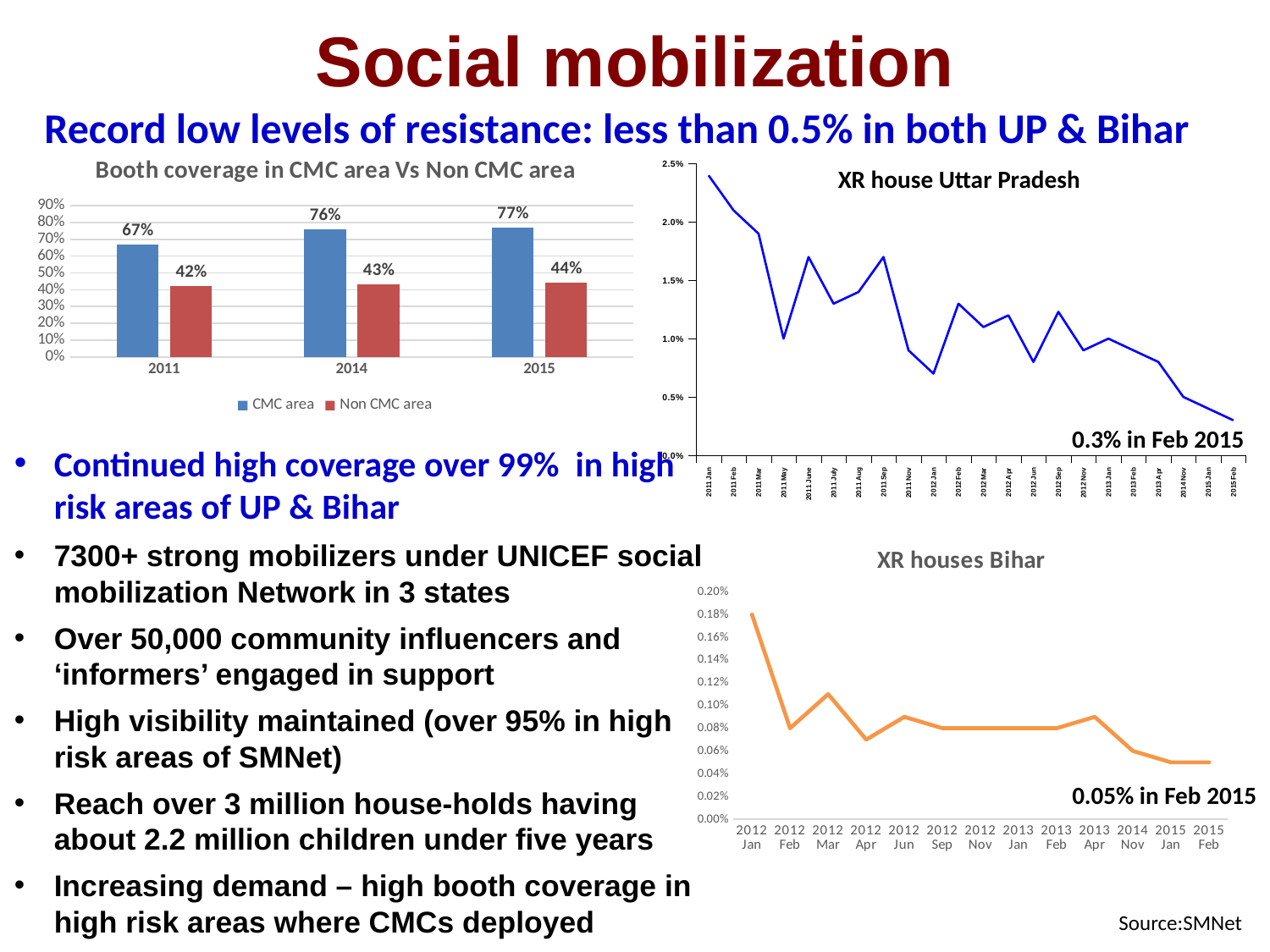
What kind of chart is 'Booth coverage in CMC area Vs Non CMC area'? Bar chart In the 'Booth coverage in CMC area Vs Non CMC area' chart, which is larger in 2011: the CMC area value or the Non CMC area value? CMC area In the 'XR houses Bihar' chart, what is the value in Feb 2015? 0.05% In the 'XR house Uttar Pradesh' chart, do the values generally rise or fall over time? Fall In the 'Booth coverage in CMC area Vs Non CMC area' chart, which year has the highest CMC area value? 2015 In the 'Booth coverage in CMC area Vs Non CMC area' chart, how many series does the legend list? 2 In the 'Booth coverage in CMC area Vs Non CMC area' chart, what is the difference between the CMC area and Non CMC area values in 2015? 33% In the 'XR houses Bihar' chart, how many points are plotted along the x axis? 13 In the 'Booth coverage in CMC area Vs Non CMC area' chart, what is the Non CMC area value for 2011? 42% In the 'XR house Uttar Pradesh' chart, what is the value in Feb 2015? 0.3% In the 'XR house Uttar Pradesh' chart, is the value for 2011 Jan greater or less than 2.0%? greater In the 'Booth coverage in CMC area Vs Non CMC area' chart, what is the CMC area value for 2014? 76%